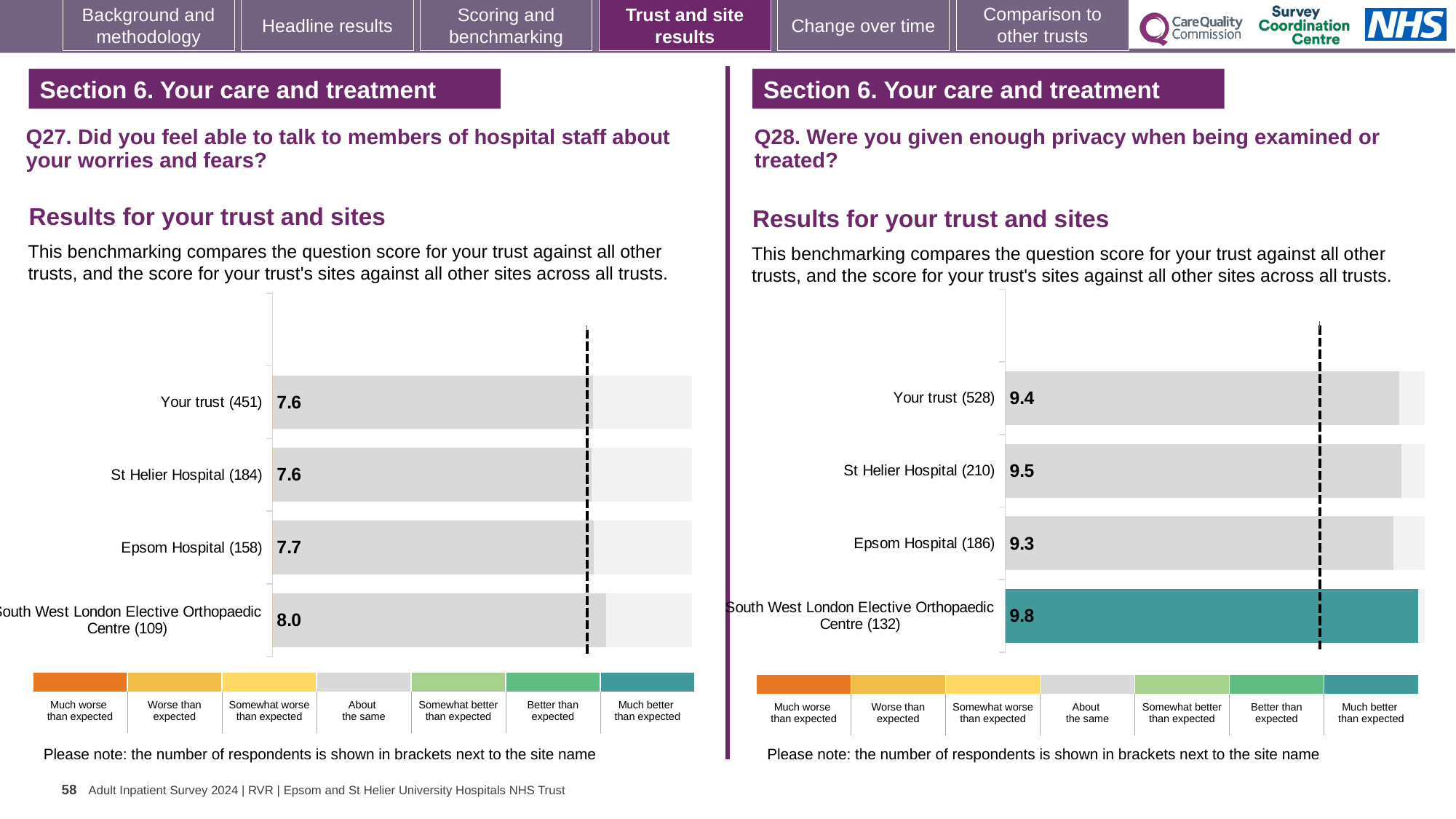
What type of chart is used for the Q28 results on the right? Bar chart In the Q28 chart on the right, which site has the lowest score? Epsom Hospital (186) In the Q28 chart on the right, which site has the highest score? South West London Elective Orthopaedic Centre (132) In the Q28 chart on the right, what is the difference between the scores for South West London Elective Orthopaedic Centre (132) and Your trust (528)? 0.4 In the Q27 chart on the left, which site has the highest score? South West London Elective Orthopaedic Centre (109) In the Q27 chart on the left, what is the difference between the scores for South West London Elective Orthopaedic Centre (109) and St Helier Hospital (184)? 0.4 How many bars are shown in the Q27 chart on the left? 4 In the Q27 chart on the left, what is the score for Epsom Hospital (158)? 7.7 In the Q28 chart on the right, what is the score for St Helier Hospital (210)? 9.5 In the Q27 chart on the left, what is the score for Your trust (451)? 7.6 In the Q28 chart on the right, what is the score for South West London Elective Orthopaedic Centre (132)? 9.8 In the Q28 chart on the right, which has the higher score: St Helier Hospital (210) or Epsom Hospital (186)? St Helier Hospital (210)